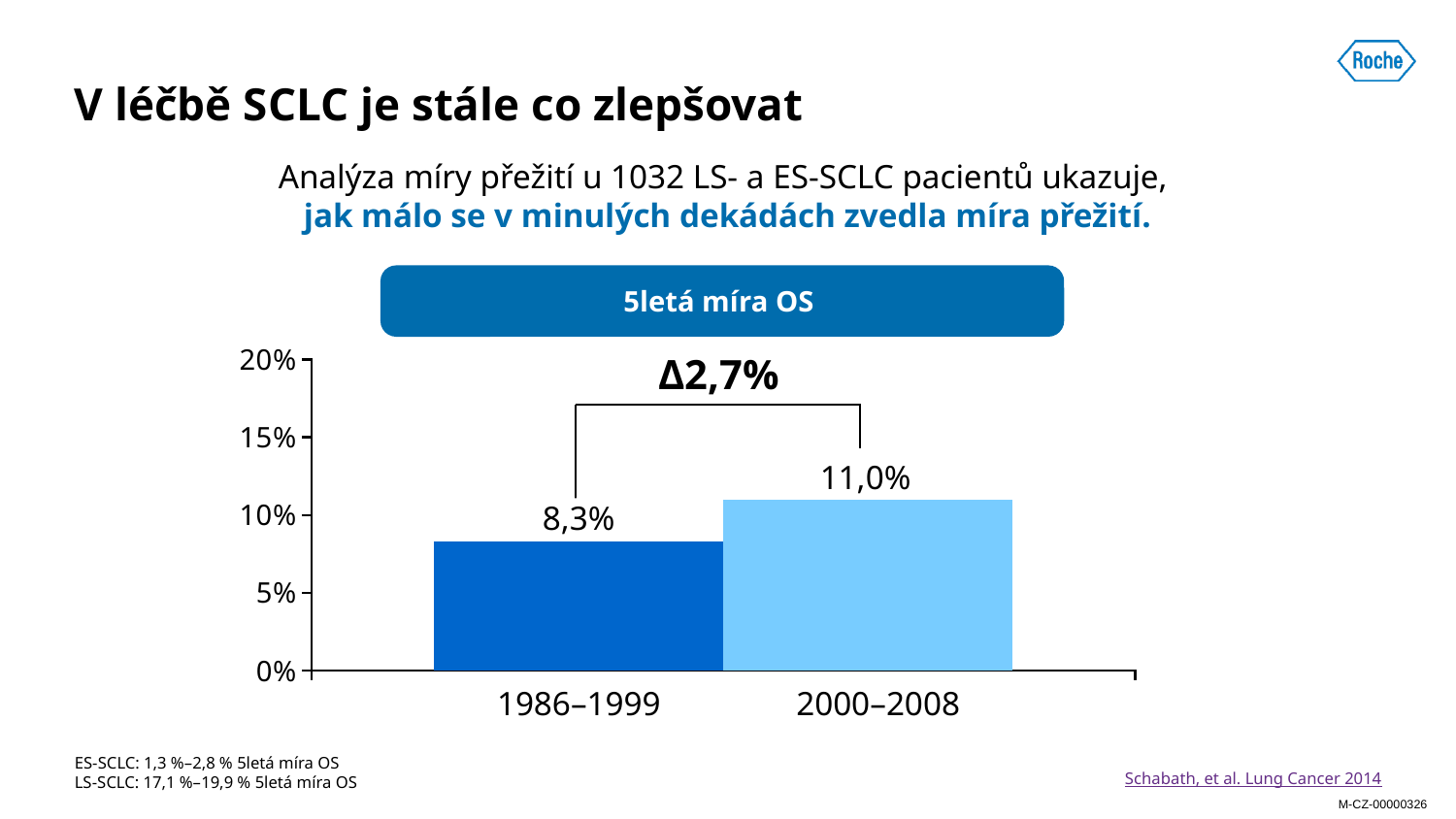
Is the 5-year OS rate for 2000–2008 greater or less than 10%? greater What is the 5-year OS rate shown for 1986–1999? 8,3% Is the 5-year OS rate for 1986–1999 greater or less than 10%? less What is the difference between the 5-year OS rates for 2000–2008 and 1986–1999? 2,7% What is the title shown above the chart? 5letá míra OS Which period has the higher 5-year OS rate? 2000–2008 What kind of chart is shown on the slide? Bar chart What is the maximum value shown on the y-axis of the chart? 20% Which period has the lower 5-year OS rate? 1986–1999 How many periods (categories) are shown on the chart? 2 Do the values rise or fall from 1986–1999 to 2000–2008? Rise What is the 5-year OS rate shown for 2000–2008? 11,0%